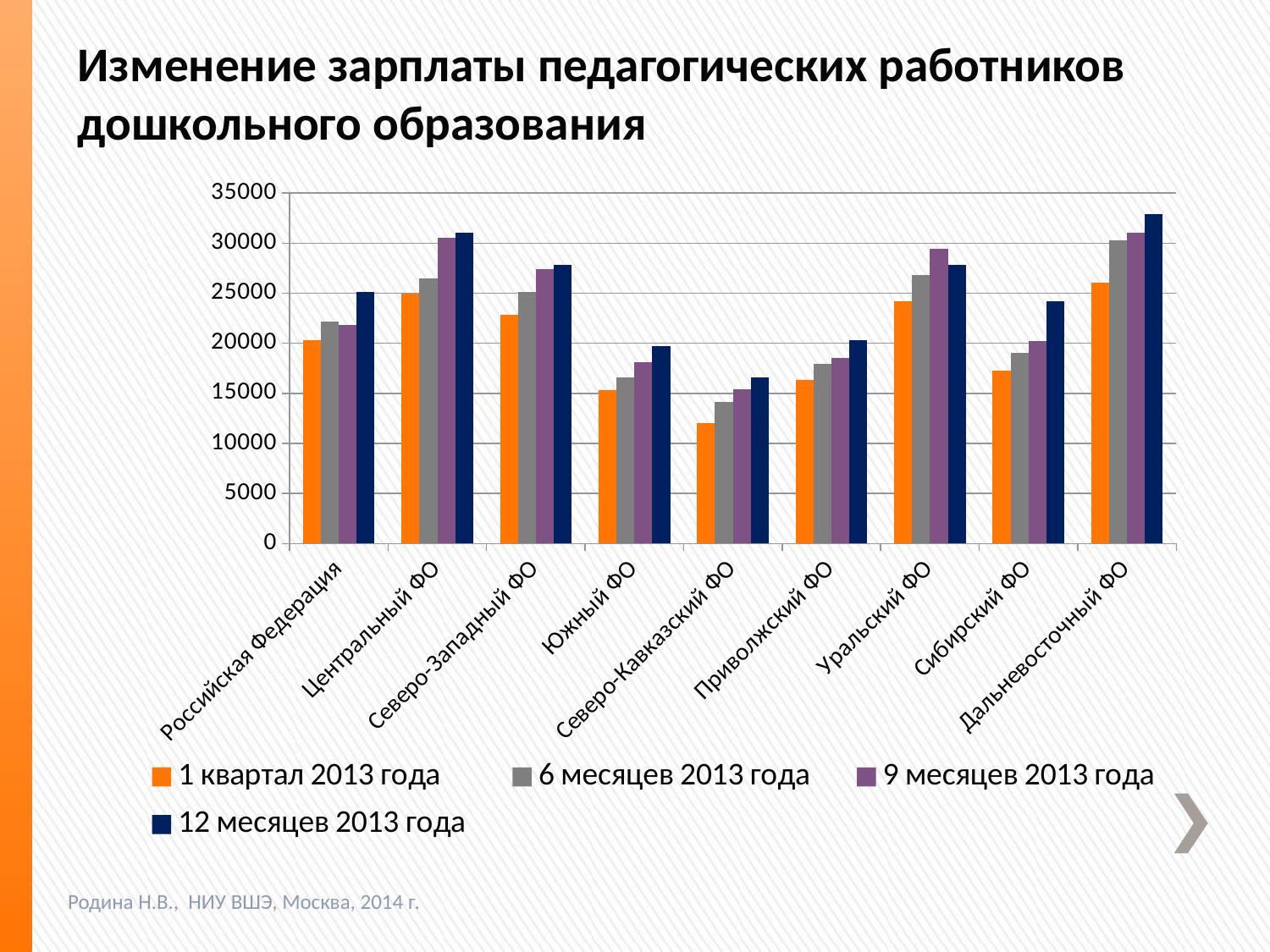
Which region has the lowest value for the series '12 месяцев 2013 года'? Северо-Кавказский ФО Which region has the highest value for the series '12 месяцев 2013 года'? Дальневосточный ФО For Уральский ФО, which is larger: the value for '9 месяцев 2013 года' or for '12 месяцев 2013 года'? 9 месяцев 2013 года How many categories (regions) are shown on the x axis? 9 How many series does the legend list? 4 Is the value for Северо-Кавказский ФО in '1 квартал 2013 года' greater or less than 15000? less Is the value for Дальневосточный ФО in '12 месяцев 2013 года' greater or less than 30000? greater Which series is shown in orange in the legend? 1 квартал 2013 года Which region has the lowest value for the series '1 квартал 2013 года'? Северо-Кавказский ФО What kind of chart is shown on the slide? bar chart For the series '12 месяцев 2013 года', which is larger: Центральный ФО or Уральский ФО? Центральный ФО Is the value for Уральский ФО in '9 месяцев 2013 года' greater or less than 25000? greater